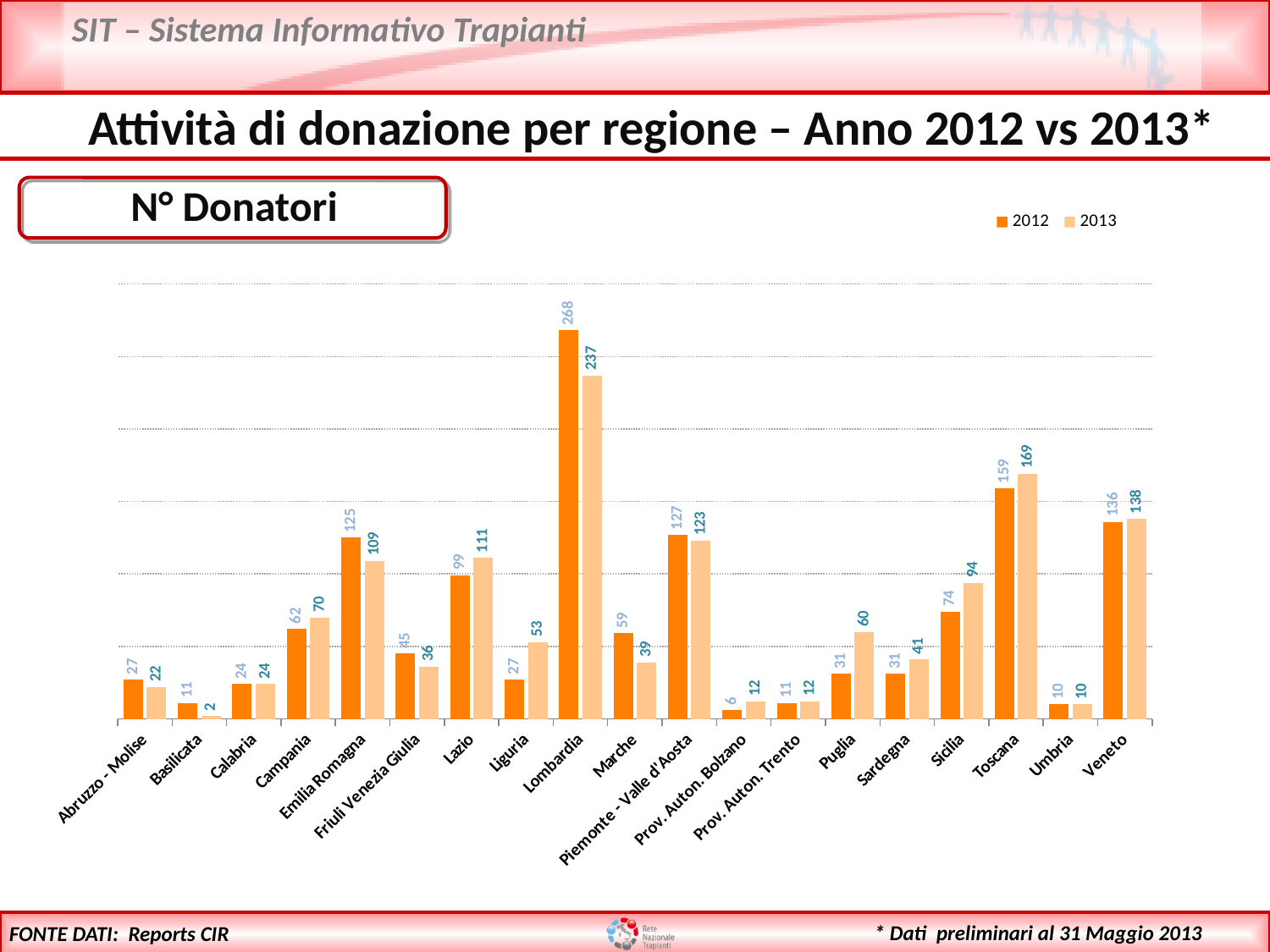
What is the number of donors for Toscana in 2013? 169 What are the two series named in the legend? 2012 and 2013 What kind of chart is shown on the slide? Bar chart How many series does the legend list? 2 What is the difference between the 2012 and 2013 values for Lombardia? 31 Which is larger for Emilia Romagna, the 2012 value or the 2013 value? 2012 How many regions are shown on the x axis? 19 What is the 2013 value for Puglia? 60 What is the total of the 2012 and 2013 values for Umbria? 20 What is the number of donors for Lombardia in 2012? 268 Which region has the highest number of donors in 2012? Lombardia Which region has the lowest number of donors in 2013? Basilicata